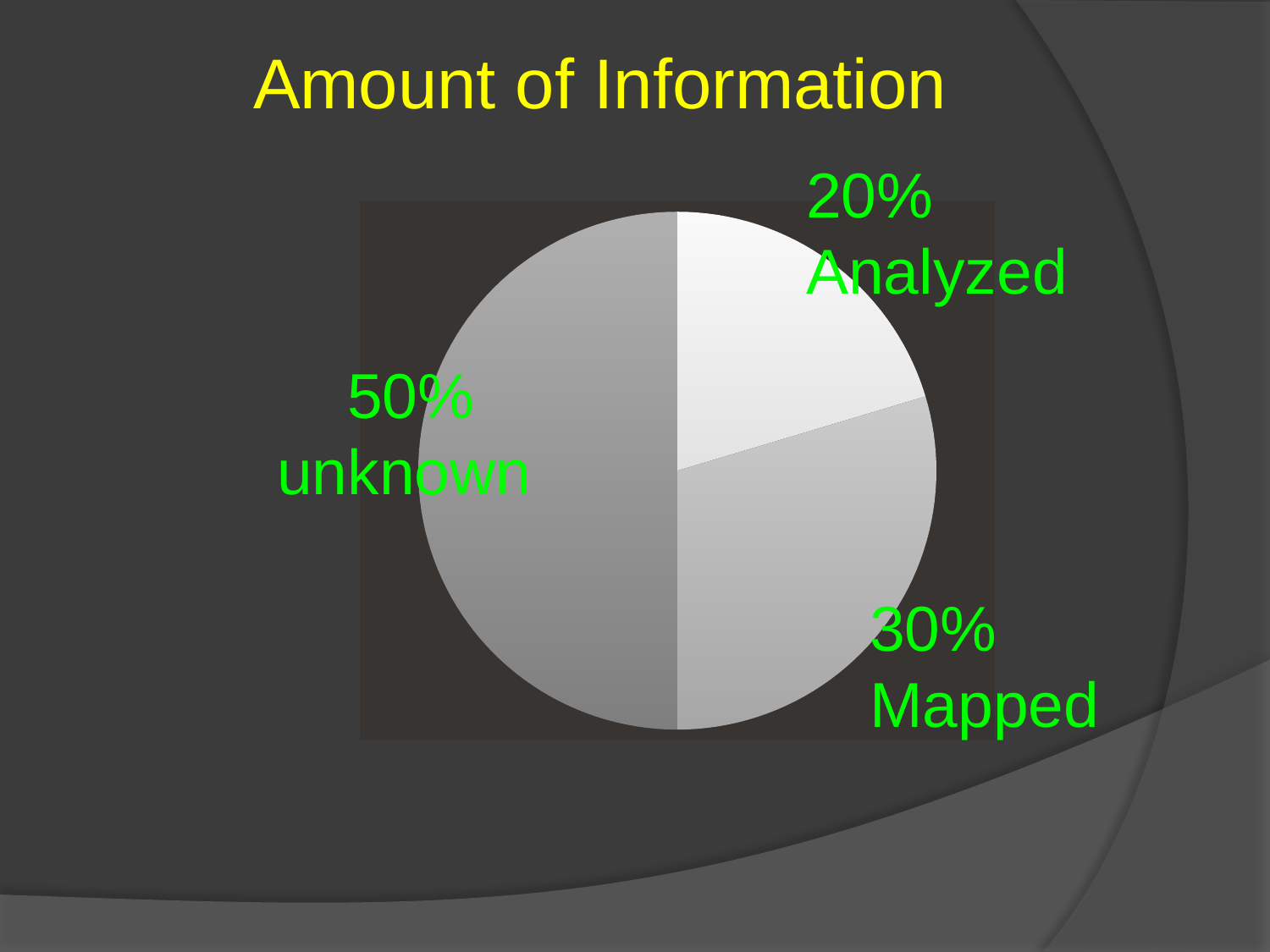
Which is larger, the Mapped slice or the Analyzed slice? Mapped What is the combined share of the Analyzed and Mapped slices? 50% What is the title of the chart? Amount of Information What is the difference between the Mapped share and the Analyzed share? 10% Which slice of the pie is the smallest? Analyzed How many slices does the pie chart have? 3 What share of the pie is labelled Mapped? 30% What share of the pie is labelled unknown? 50% Which slice of the pie is the largest? unknown What kind of chart is shown on the slide? pie chart What share of the pie is labelled Analyzed? 20% What is the difference between the unknown share and the Mapped share? 20%